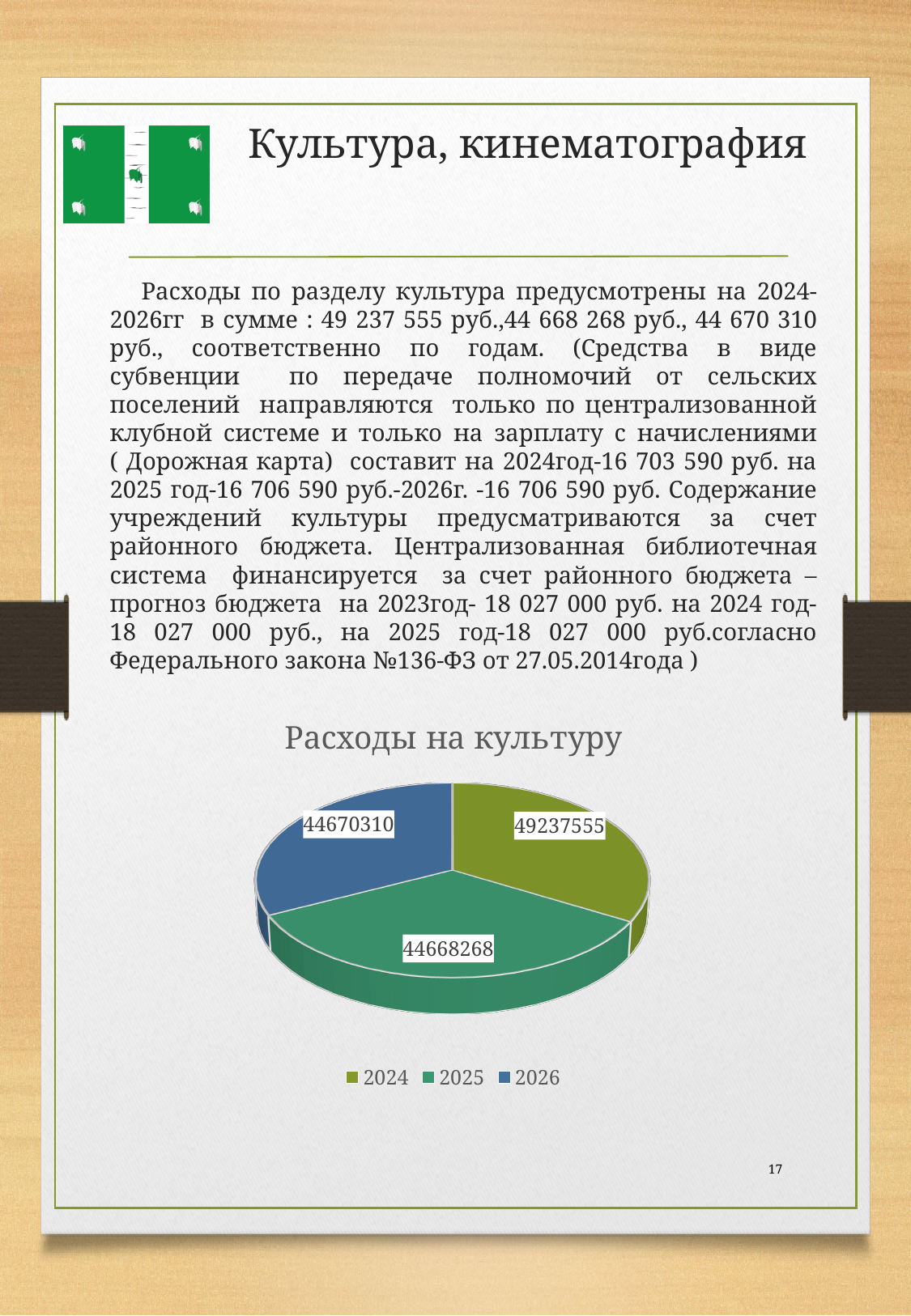
Which is larger, the value for 2024 or the value for 2025? 2024 What is the value shown for 2024 in the pie chart? 49237555 What is the total of all three values in the pie chart? 138576133 What is the title of the chart on the slide? Расходы на культуру What is the value shown for 2026 in the pie chart? 44670310 What kind of chart is shown on the slide? Pie chart What is the value shown for 2025 in the pie chart? 44668268 How many entries does the legend of the pie chart list? 3 How many slices does the pie chart have? 3 What is the difference between the values for 2024 and 2026? 4567245 What is the difference between the values for 2024 and 2025? 4569287